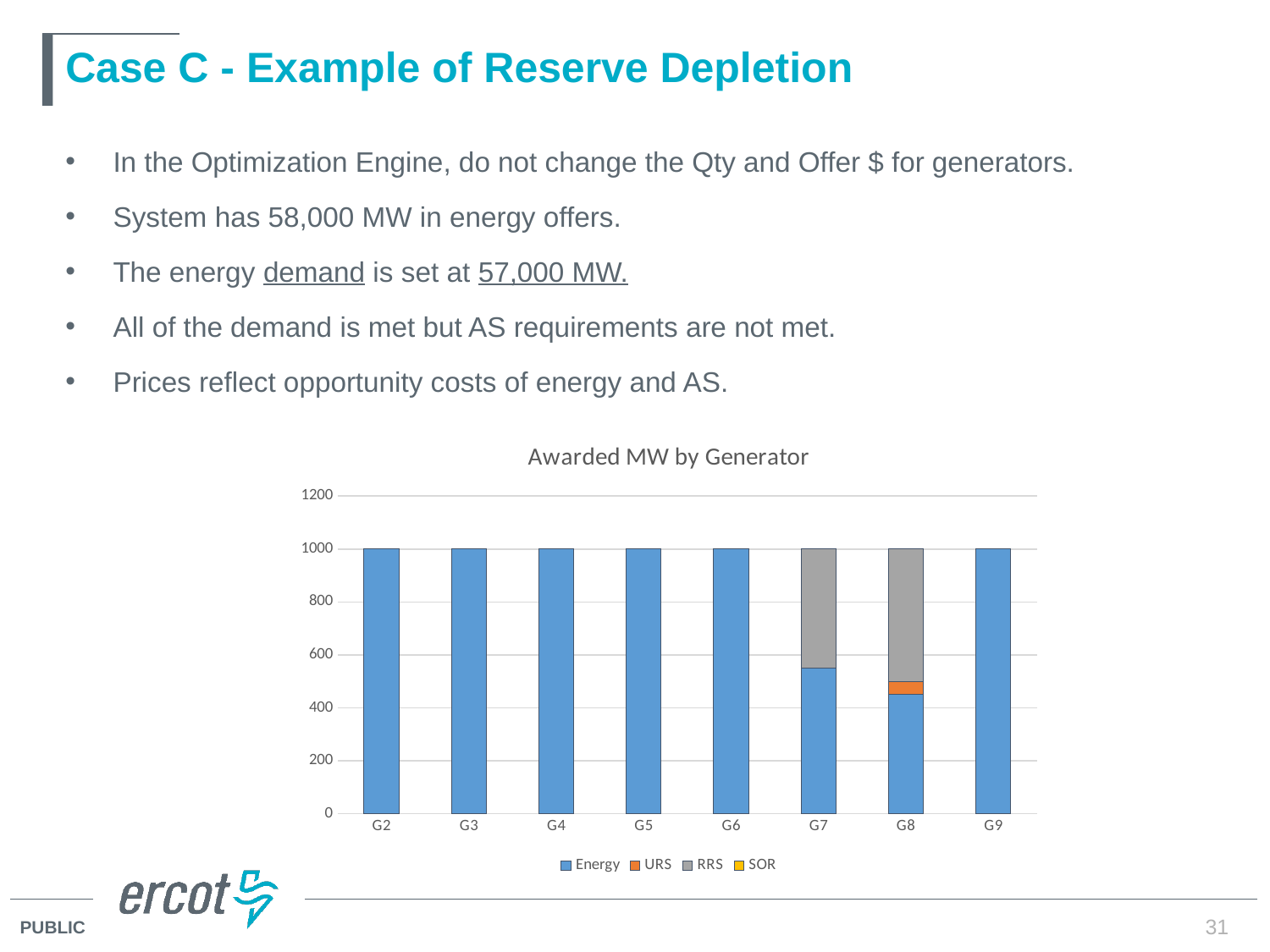
What kind of chart is shown on the slide? Stacked bar chart What is the title of the chart? Awarded MW by Generator What is the total height of the stacked bar for G8? 1000 Which generator has the lowest Energy value? G8 Which series are listed in the chart legend? Energy, URS, RRS, SOR How many generators are shown on the x axis of the chart? 8 Is the Energy value for G7 greater or less than 600? less What is the total height of the stacked bar for G7? 1000 What is the Energy value awarded to G2? 1000 Is the Energy value for G8 greater or less than 600? less Which has the larger Energy value, G7 or G8? G7 How many series does the chart legend list? 4